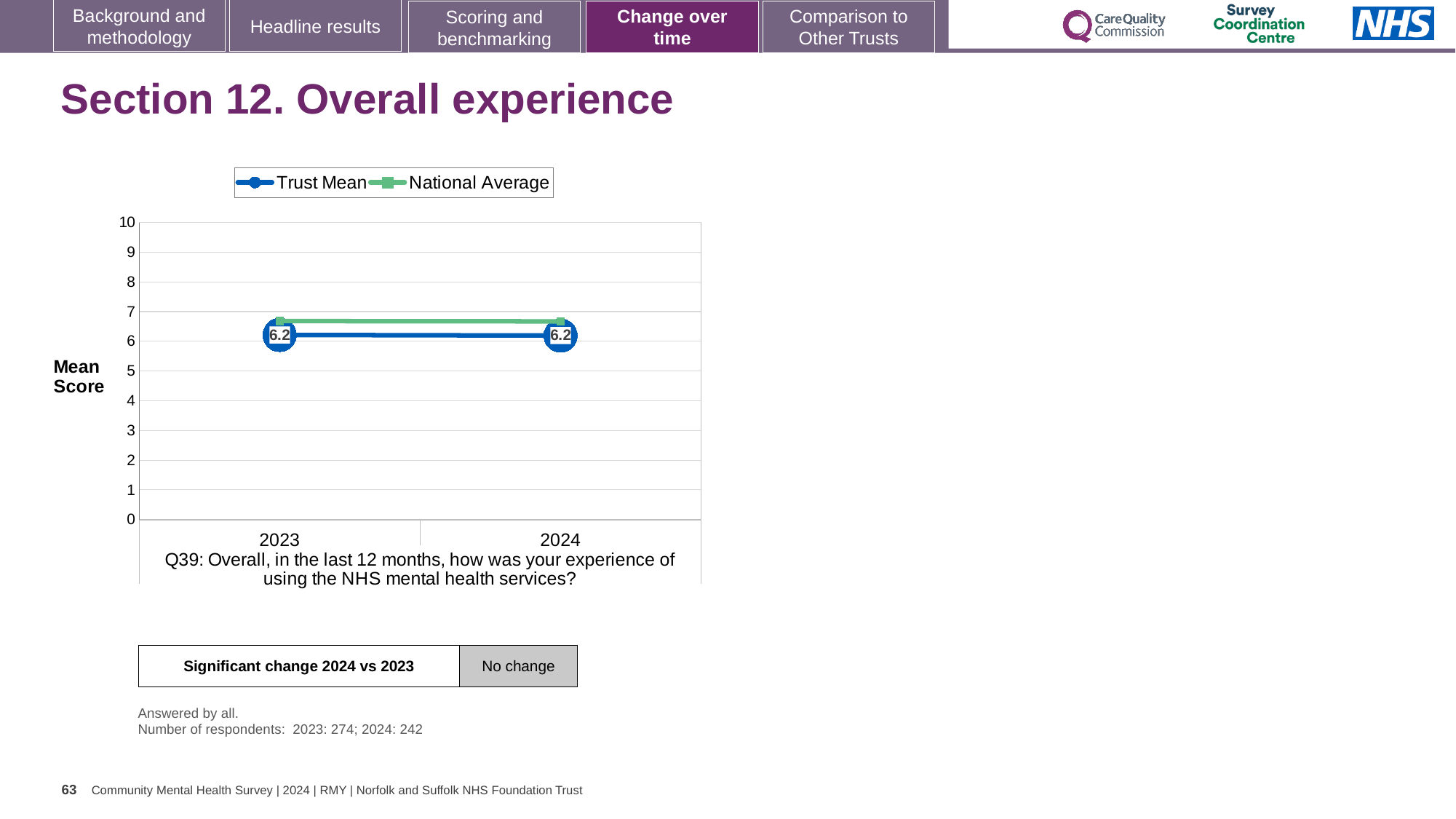
Is the National Average value for 2023 greater or less than 7? less What is the Trust Mean value for 2024? 6.2 How many series does the chart legend list? 2 What kind of chart is shown on the slide? line chart Is the National Average value for 2024 greater or less than 6? greater How many years are plotted on the x axis of the chart? 2 What are the two series named in the chart legend? Trust Mean and National Average What is the label on the y axis of the chart? Mean Score In 2023, which is larger: the Trust Mean or the National Average? National Average Does the Trust Mean rise, fall or stay the same from 2023 to 2024? stays the same What is the Trust Mean value for 2023? 6.2 What is the difference between the Trust Mean in 2024 and the Trust Mean in 2023? 0